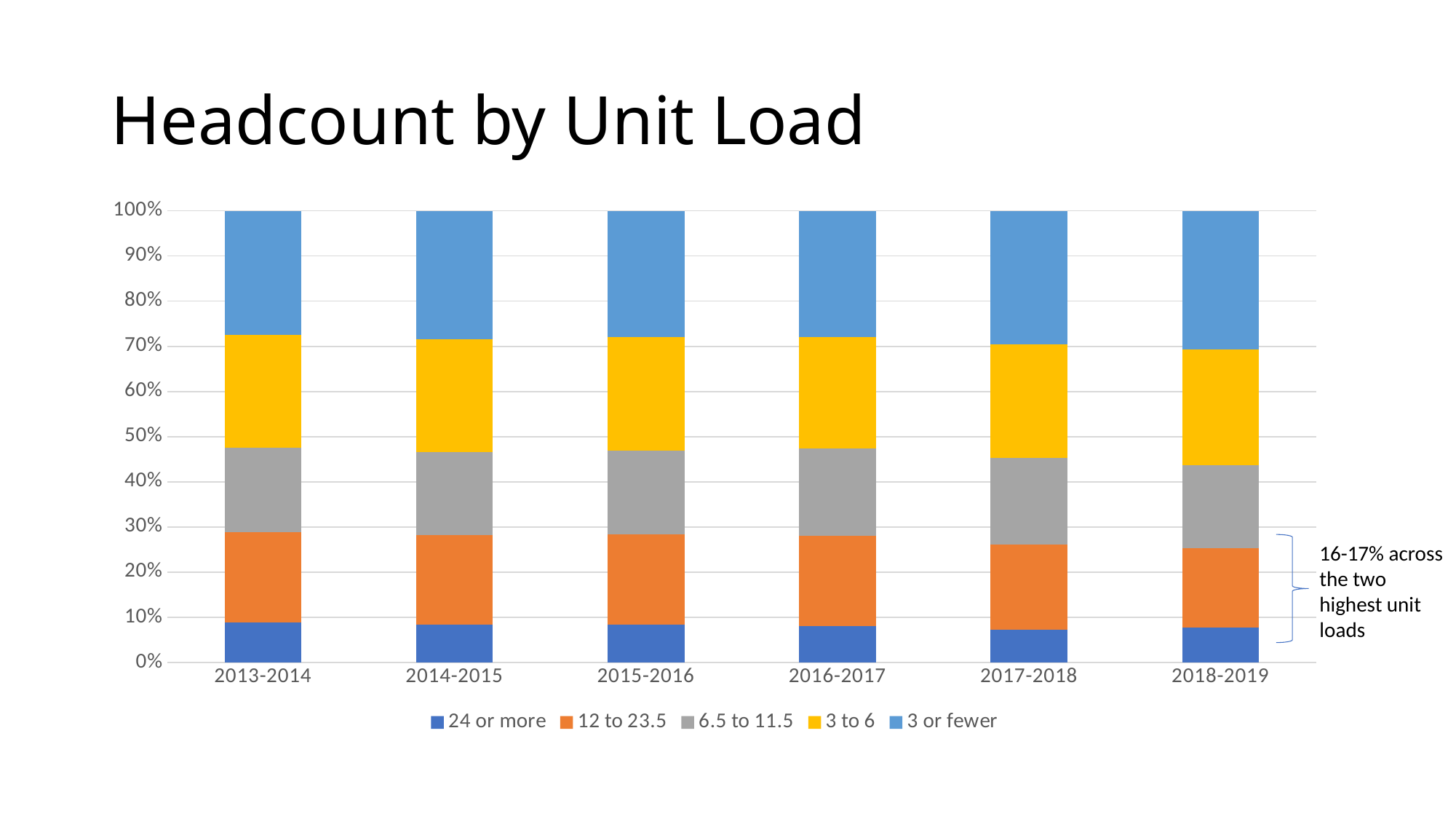
What does each stacked bar total? 100% Which series is shown in orange in the legend? 12 to 23.5 Does the combined share of the two highest unit loads ('24 or more' and '12 to 23.5') rise or fall from 2013-2014 to 2018-2019? fall How many academic years are shown on the x axis? 6 Is the cumulative top of the '12 to 23.5' segment in 2018-2019 greater or less than 30%? less What kind of chart is shown on the slide? Stacked bar chart What is the title of the chart? Headcount by Unit Load Is the share for '24 or more' in 2013-2014 greater or less than 10%? less In 2018-2019, which has the larger share: '3 or fewer' or '3 to 6'? 3 or fewer Which unit load category has the smallest share of headcount in 2013-2014? 24 or more Is the cumulative top of the '6.5 to 11.5' segment in 2018-2019 greater or less than 50%? less How many series does the legend list? 5